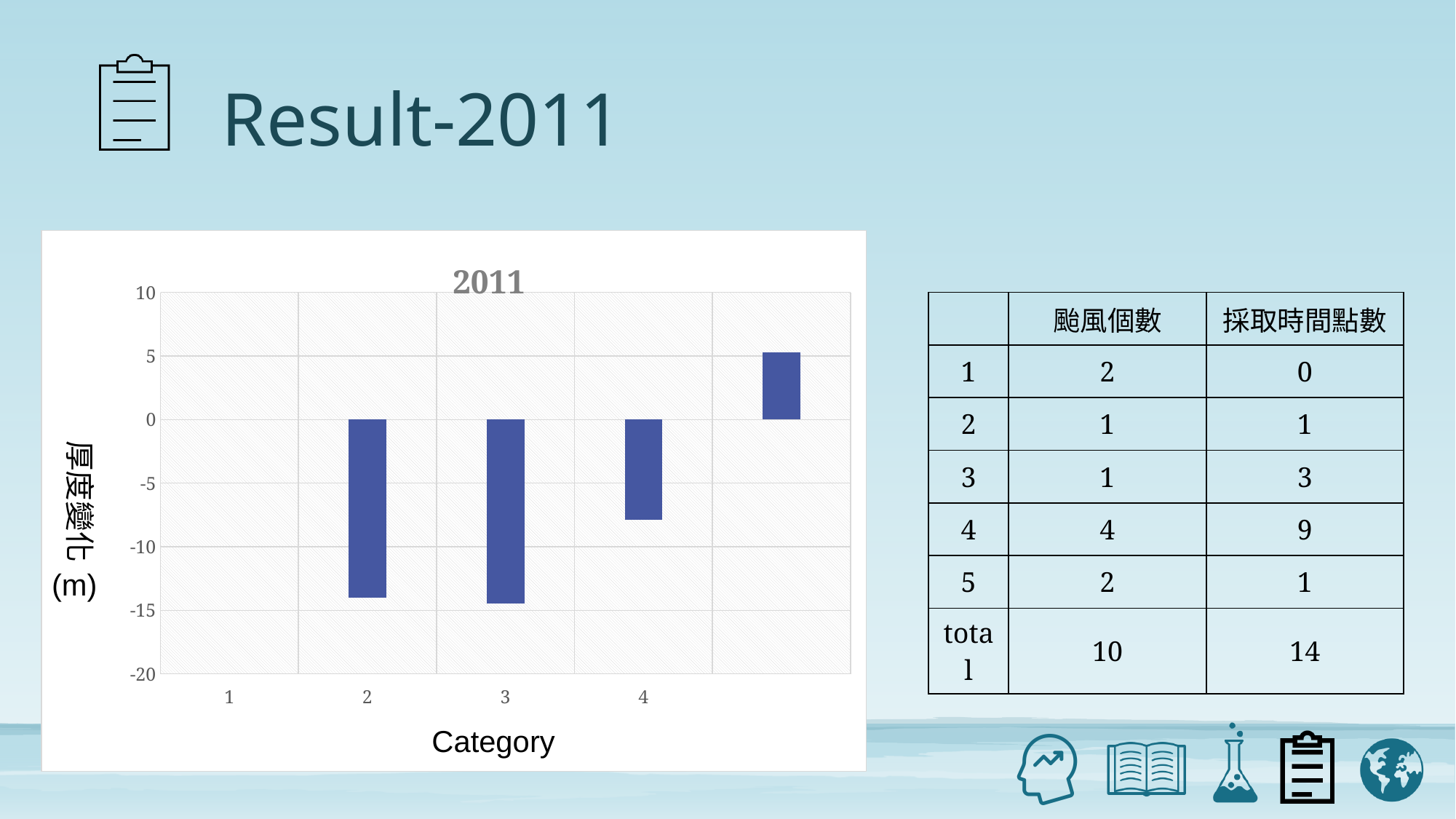
Which has the lower value, category 3 or category 4? category 3 What is the title of the chart? 2011 Is the value for category 4 greater or less than -10? greater How many bars in the chart extend below zero? 3 Is the value for category 2 greater or less than 0? less Is the value for category 3 greater or less than -10? less What is the highest value shown on the y axis of the chart? 10 Which has the larger value, category 2 or category 4? category 4 What kind of chart is shown on the slide? bar chart What is the label on the x axis of the chart? Category